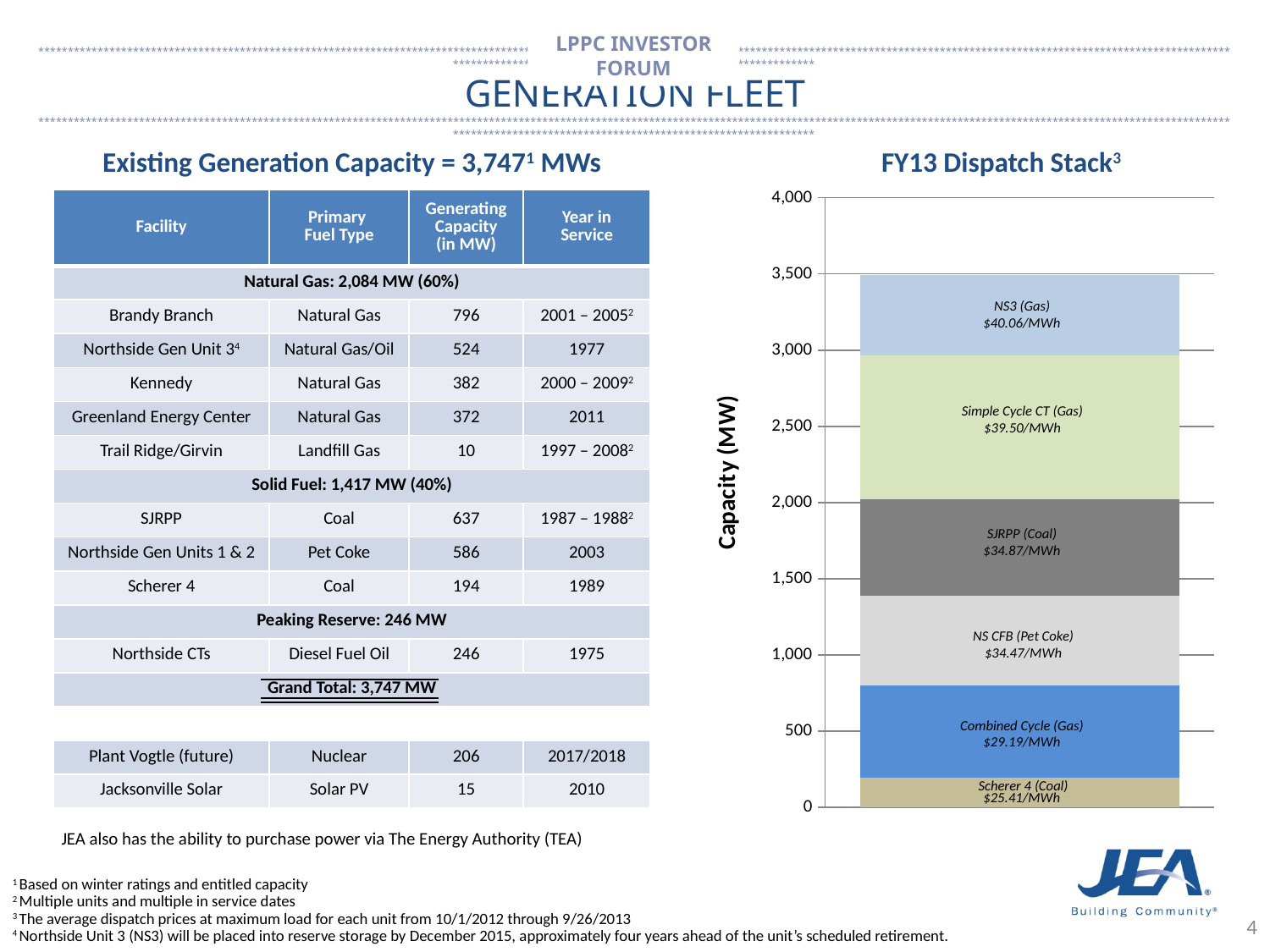
In the FY13 Dispatch Stack chart, is the total height of the stacked bar greater or less than 3,000 MW? greater In the FY13 Dispatch Stack chart, which has the higher dispatch price, NS CFB (Pet Coke) or Simple Cycle CT (Gas)? Simple Cycle CT (Gas) In the FY13 Dispatch Stack chart, what is the difference between the dispatch prices of NS3 (Gas) and Scherer 4 (Coal)? $14.65/MWh In the FY13 Dispatch Stack chart, what is the dispatch price shown for SJRPP (Coal)? $34.87/MWh In the FY13 Dispatch Stack chart, which segment has the highest dispatch price? NS3 (Gas) In the FY13 Dispatch Stack chart, what is the dispatch price shown for Scherer 4 (Coal)? $25.41/MWh How many segments make up the stacked bar in the FY13 Dispatch Stack chart? 6 What type of chart is the FY13 Dispatch Stack? Stacked bar chart In the FY13 Dispatch Stack chart, what is the dispatch price shown for NS3 (Gas)? $40.06/MWh In the FY13 Dispatch Stack chart, what is the dispatch price shown for Combined Cycle (Gas)? $29.19/MWh In the FY13 Dispatch Stack chart, which segment has the lowest dispatch price? Scherer 4 (Coal) What is the y-axis title of the FY13 Dispatch Stack chart? Capacity (MW)